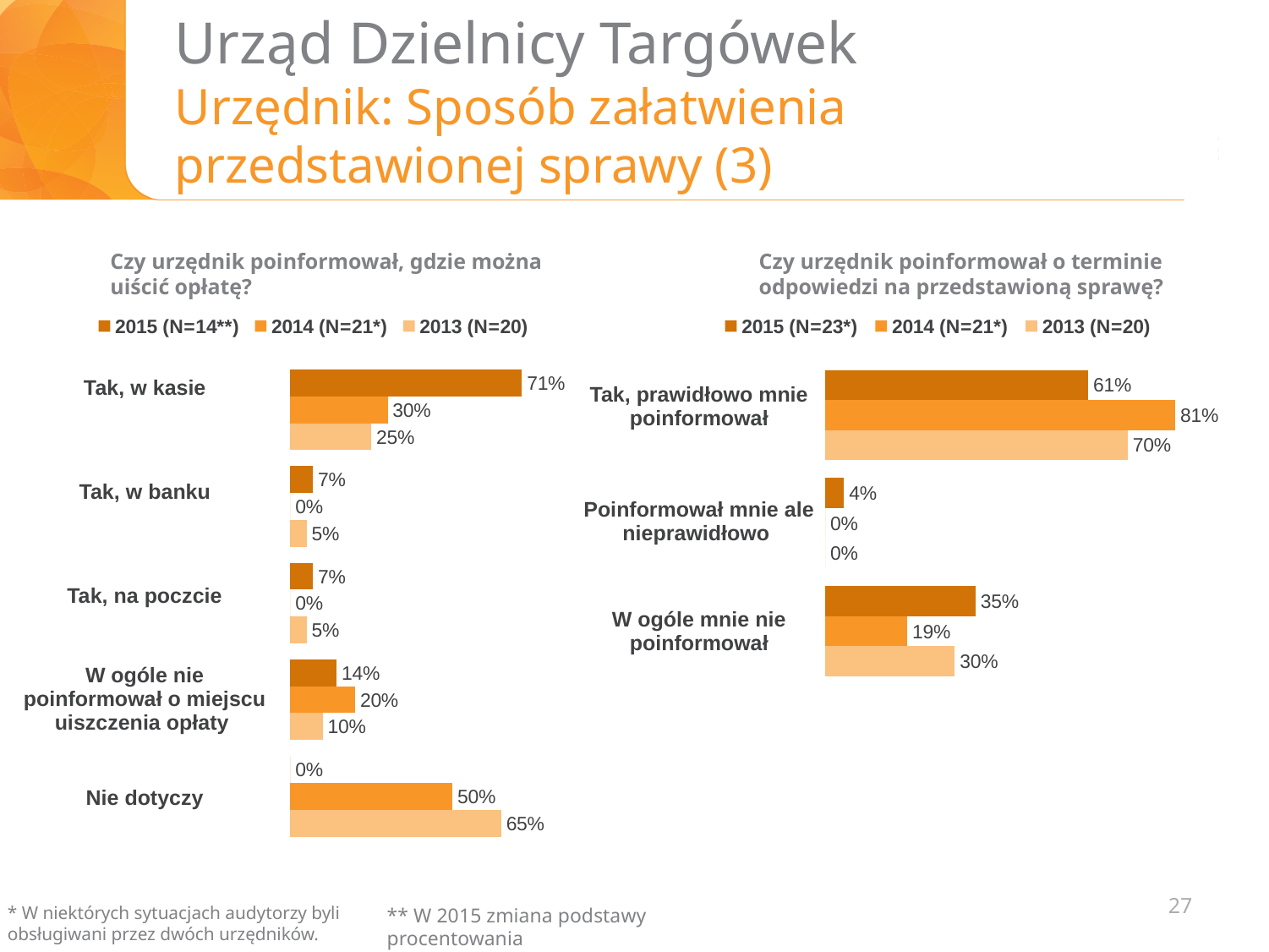
How many categories are shown in the left chart? 5 In the left chart, which category has the lowest value for 2015? Nie dotyczy What type of chart is used on this slide? Bar chart In the right chart, which year has the highest value for "Tak, prawidłowo mnie poinformował"? 2014 In the left chart, what is the difference between the 2015 and 2014 values for "Tak, w kasie"? 41 percentage points In the right chart, what is the value for "W ogóle mnie nie poinformował" in 2015? 35% How many series does the legend of the right chart list? 3 In the left chart, what is the value for "Nie dotyczy" in 2013? 65% In the left chart, which is larger for "W ogóle nie poinformował o miejscu uiszczenia opłaty": the 2014 value or the 2013 value? 2014 In the right chart ("Czy urzędnik poinformował o terminie odpowiedzi na przedstawioną sprawę?"), what is the value for "Tak, prawidłowo mnie poinformował" in 2014? 81% In the left chart ("Czy urzędnik poinformował, gdzie można uiścić opłatę?"), what is the value for "Tak, w kasie" in 2015? 71% In the right chart, what is the difference between the 2015 and 2014 values for "W ogóle mnie nie poinformował"? 16 percentage points